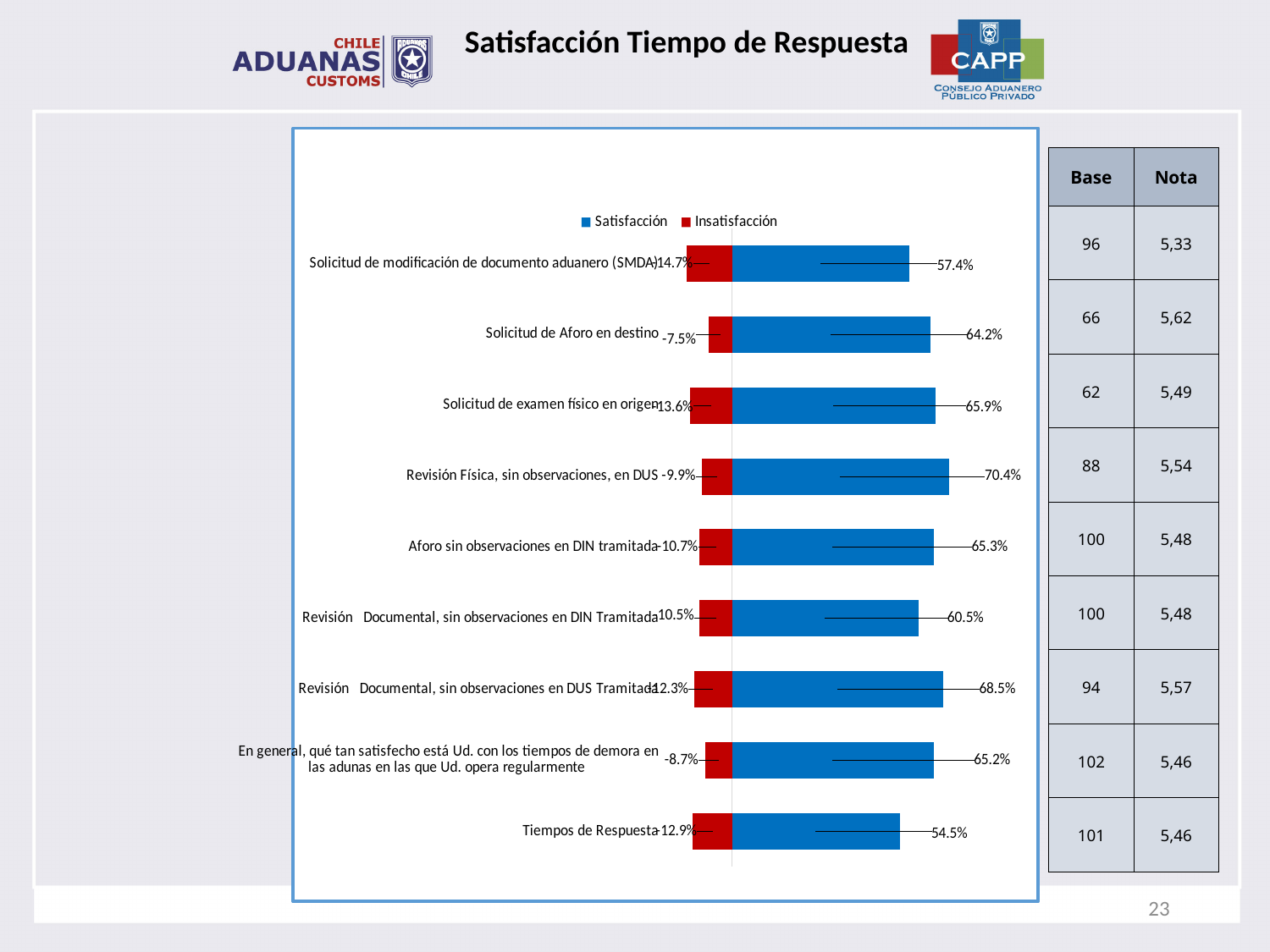
What kind of chart is shown on the slide? Bar chart Which category has the lowest Satisfacción value? Tiempos de Respuesta Which category has the highest Satisfacción value? Revisión Física, sin observaciones, en DUS How many series does the legend list? 2 What is the Satisfacción value for Solicitud de examen físico en origen? 65.9% What is the Satisfacción value for Tiempos de Respuesta? 54.5% Which colour represents the Insatisfacción series? Red What is the Satisfacción value for Revisión Física, sin observaciones, en DUS? 70.4% What is the difference between the Satisfacción values for Revisión Física, sin observaciones, en DUS and Tiempos de Respuesta? 15.9% What is the Insatisfacción value for Solicitud de Aforo en destino? -7.5% Which has a larger Satisfacción value: Solicitud de Aforo en destino or Revisión Documental, sin observaciones en DIN Tramitada? Solicitud de Aforo en destino How many categories are shown in the chart? 9